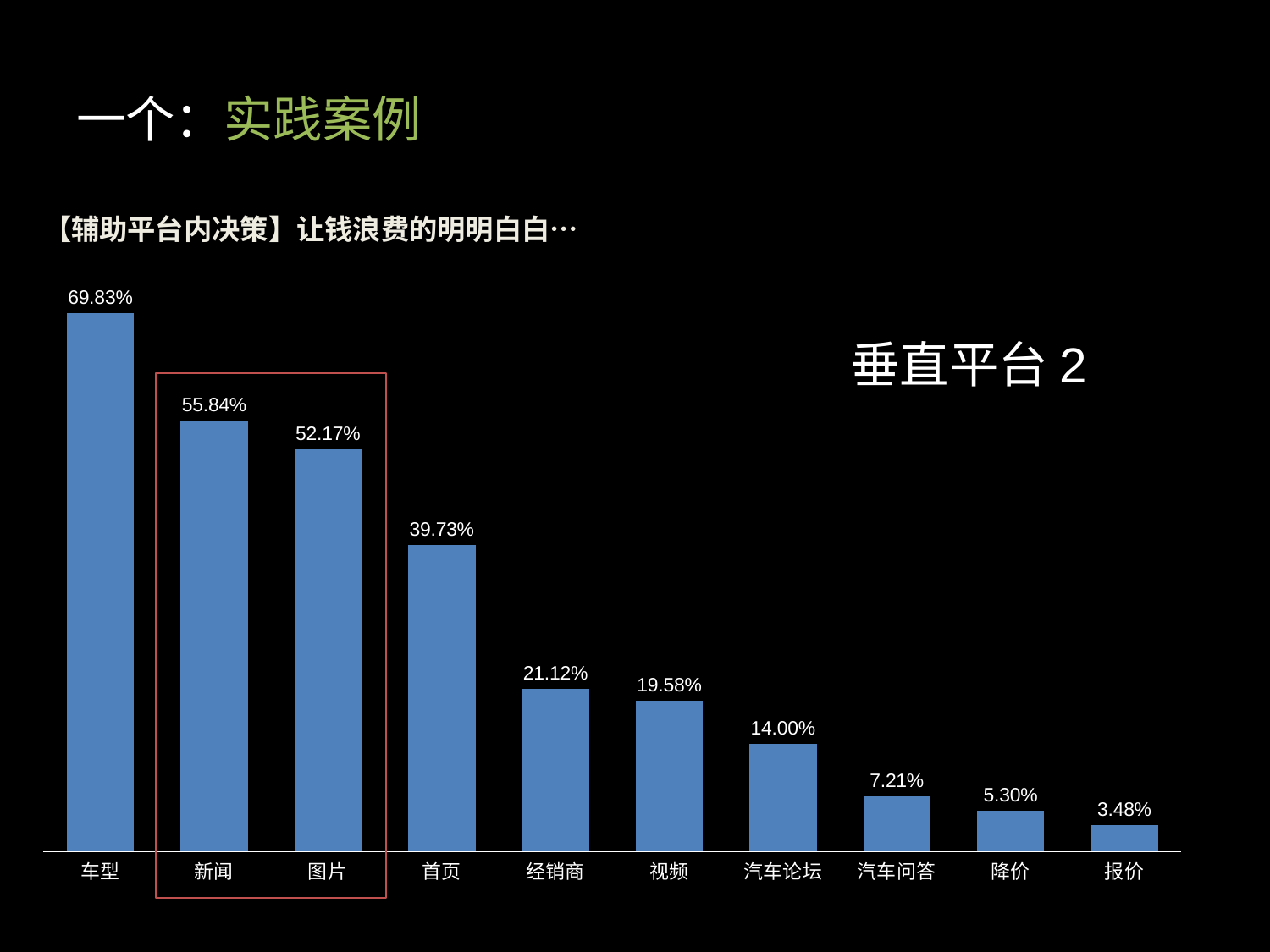
Which two categories are enclosed by the red rectangle on the chart? 新闻 and 图片 What is the difference between the values for 新闻 and 图片? 3.67% Do the values rise or fall from left to right along the x axis? fall What is the value for 经销商? 21.12% What is the value for 新闻? 55.84% Which category has the highest value? 车型 How many categories are shown in the chart? 10 What is the value for 报价? 3.48% Which is larger, the value for 首页 or the value for 视频? 首页 Which category has the lowest value? 报价 What is the value for 车型? 69.83% What kind of chart is shown on the slide? bar chart